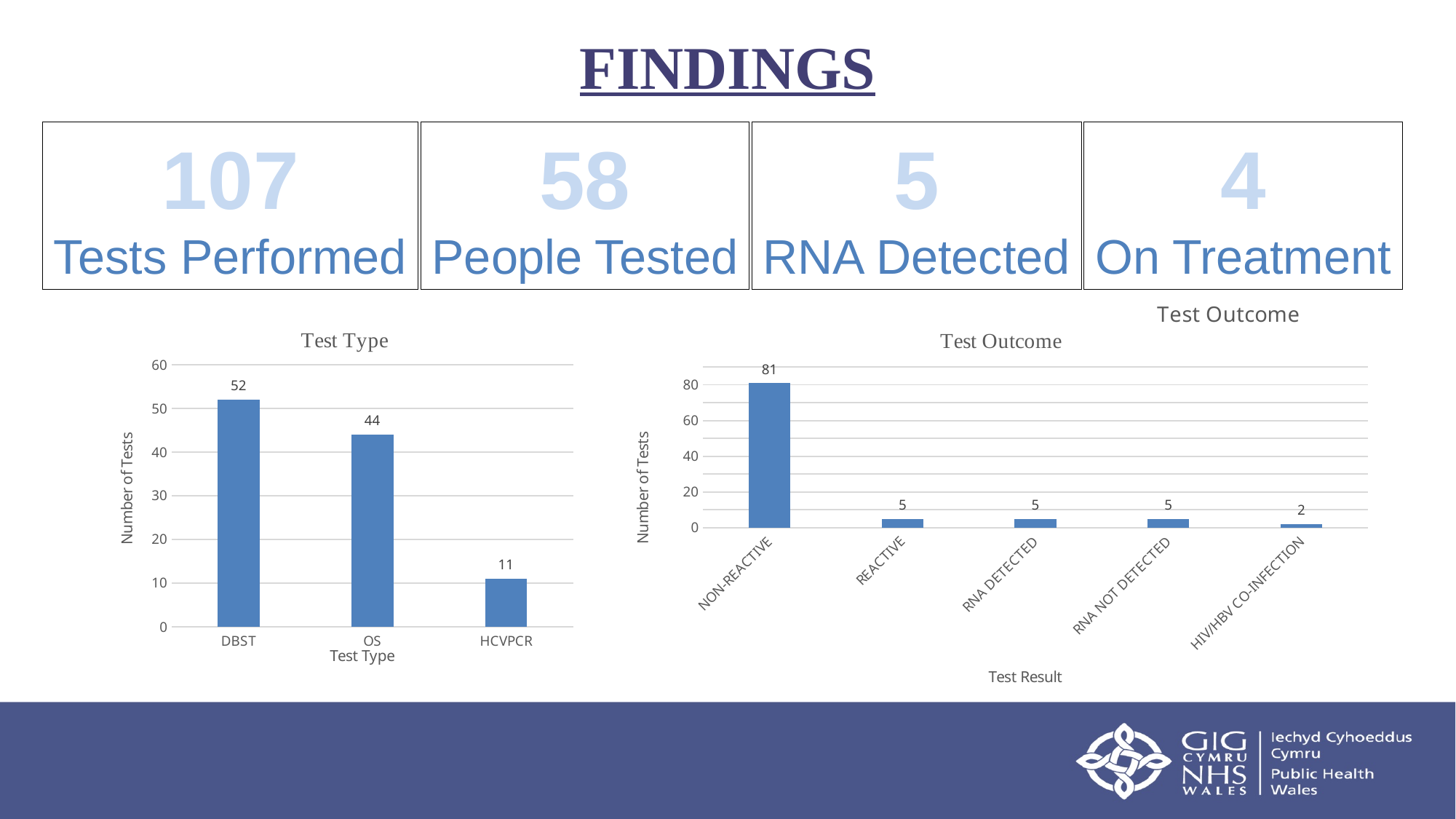
In the Test Outcome chart, how many test result categories are shown? 5 In the Test Type chart, which test type has the lowest number of tests? HCVPCR In the Test Type chart, what is the value for DBST? 52 In the Test Type chart, how many test types are shown? 3 In the Test Outcome chart, what is the value for HIV/HBV CO-INFECTION? 2 In the Test Outcome chart, is the value for NON-REACTIVE greater or less than REACTIVE? greater In the Test Type chart, what is the difference between the values for DBST and OS? 8 In the Test Type chart, what is the value for HCVPCR? 11 In the Test Type chart, which test type has the highest number of tests? DBST What kind of chart is the Test Outcome chart? bar chart In the Test Outcome chart, which test result has the lowest number of tests? HIV/HBV CO-INFECTION In the Test Outcome chart, what is the value for NON-REACTIVE? 81